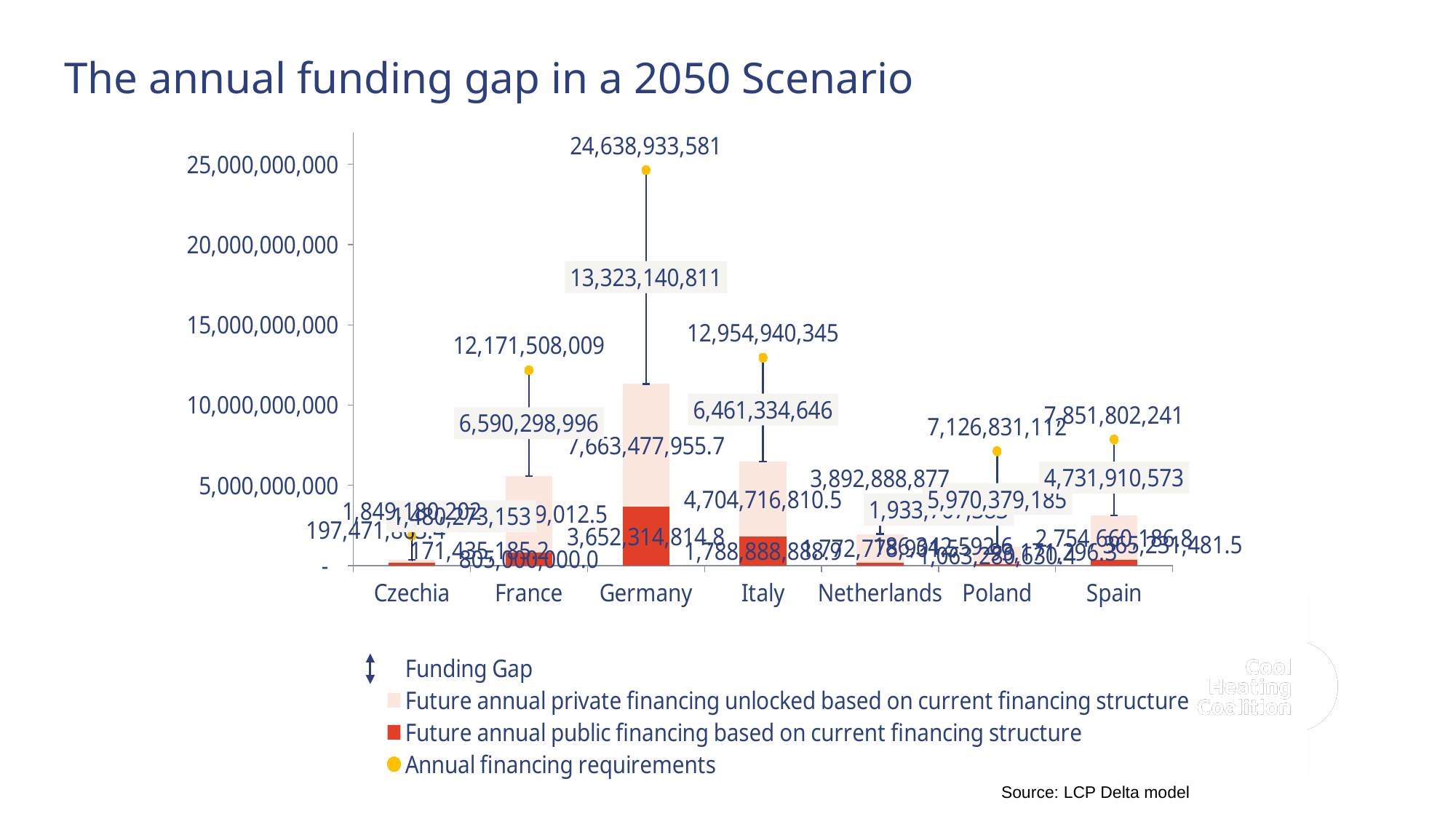
What is the annual financing requirement for Italy? 12,954,940,345 How many entries does the legend list? 4 What is the source cited for the chart? LCP Delta model What is the annual financing requirement for Germany? 24,638,933,581 Which country has the highest annual financing requirement? Germany What is the difference between the annual financing requirements of Germany and Italy? 11,683,993,236 What kind of chart is shown on the slide? bar chart How many countries are shown on the x axis? 7 Which country has the lowest annual financing requirement? Czechia What is the funding gap for Spain? 4,731,910,573 Which has the larger annual financing requirement, France or Italy? Italy What is the funding gap for Germany? 13,323,140,811